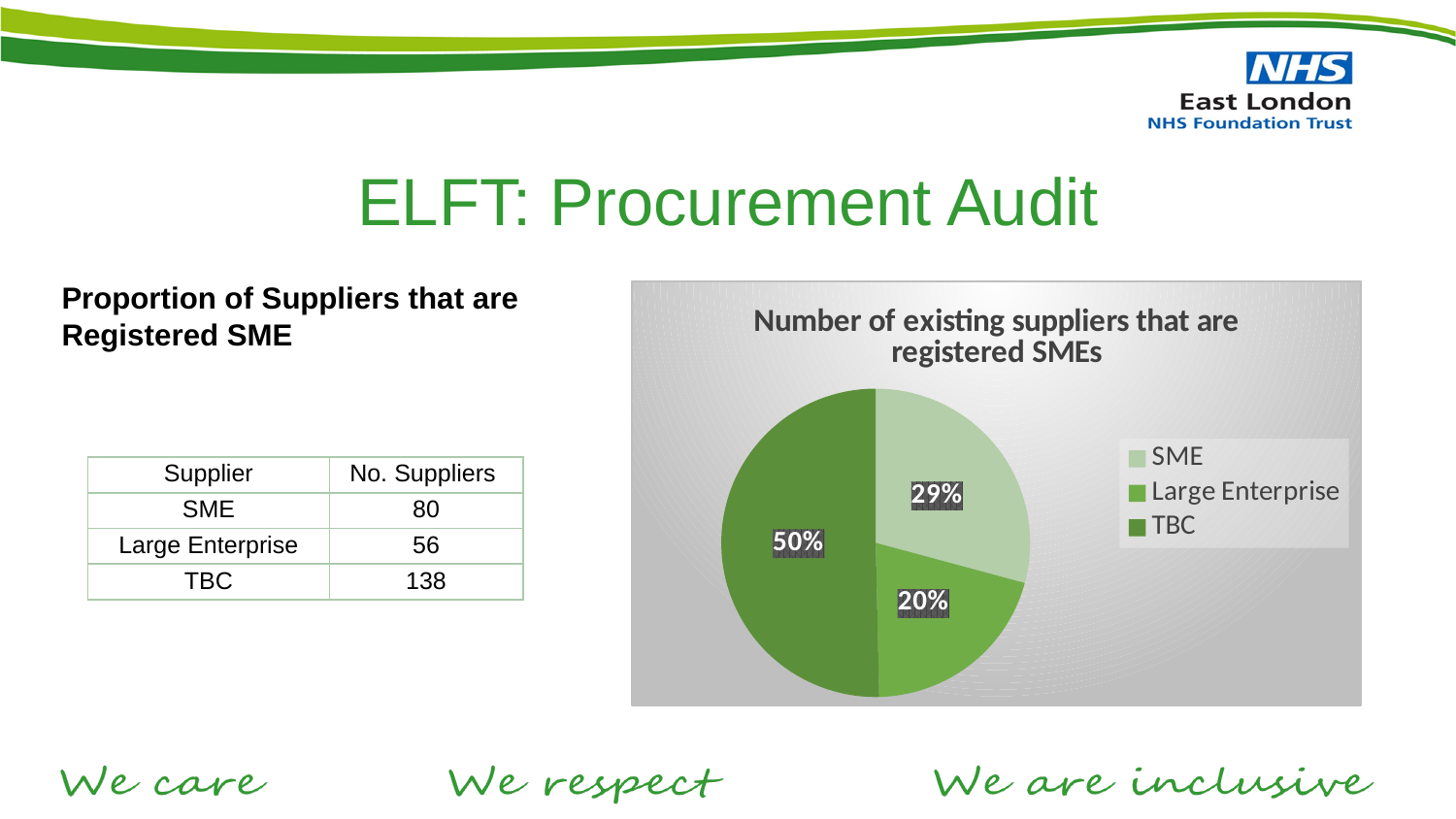
Which slice is larger, SME or Large Enterprise? SME What share of the pie does the Large Enterprise slice represent? 20% How many slices does the pie chart have? 3 Which category is shown in the darkest green in the pie chart? TBC What is the difference in percentage points between the TBC slice and the SME slice? 21 percentage points Which category has the smallest slice of the pie? Large Enterprise What share of the pie does the SME slice represent? 29% What is the title of the chart? Number of existing suppliers that are registered SMEs How many entries does the chart legend list? 3 What share of the pie does the TBC slice represent? 50% Which category has the largest slice of the pie? TBC What type of chart is shown on the slide? Pie chart